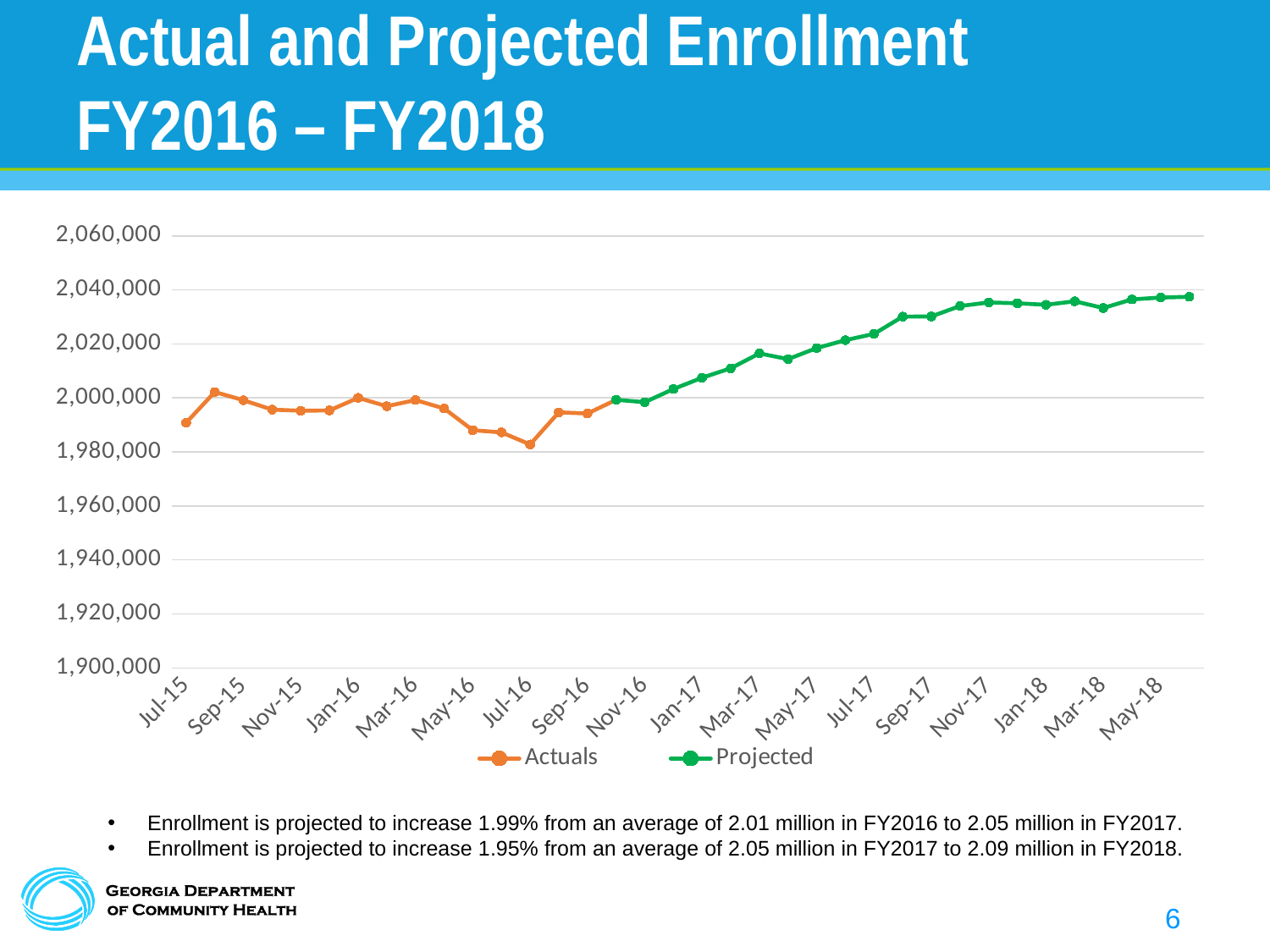
Which colour is used for the Projected series? green Is the value for Jul-15 greater or less than 2,000,000? less Which is larger, the value for Jul-16 or the value for May-18? May-18 Is the value for Jul-16 greater or less than 2,000,000? less What are the two series named in the legend? Actuals and Projected Is the value for May-18 greater or less than 2,020,000? greater What kind of chart is shown on the slide? line chart Do the values of the Projected series rise or fall from Nov-16 to May-18? rise Which month has the lowest enrollment value on the chart? Jul-16 How many series does the legend list? 2 Which is larger, the value for Jul-15 or the value for Jan-17? Jan-17